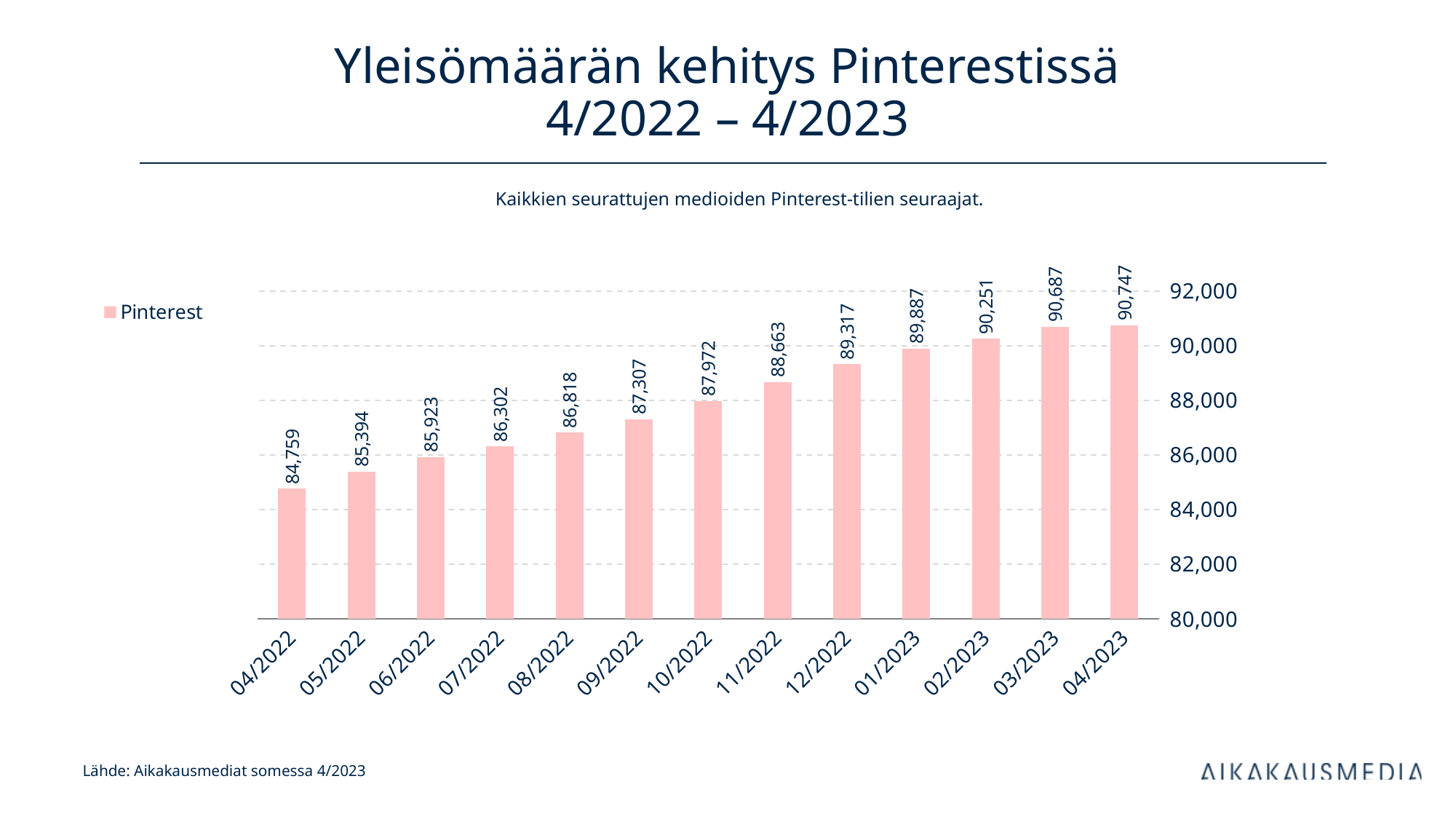
Which month has the highest value? 04/2023 What is the value for 04/2022? 84,759 Which month has the lowest value? 04/2022 Which is larger, the value for 06/2022 or the value for 11/2022? 11/2022 What is the difference between the values for 10/2022 and 09/2022? 665 Is the value for 08/2022 greater or less than 88,000? less How many months are shown on the x axis? 13 What is the difference between the values for 04/2023 and 04/2022? 5,988 What is the value for 01/2023? 89,887 Do the values rise or fall from 04/2022 to 04/2023? rise What type of chart is shown on the slide? bar chart What is the value for 10/2022? 87,972